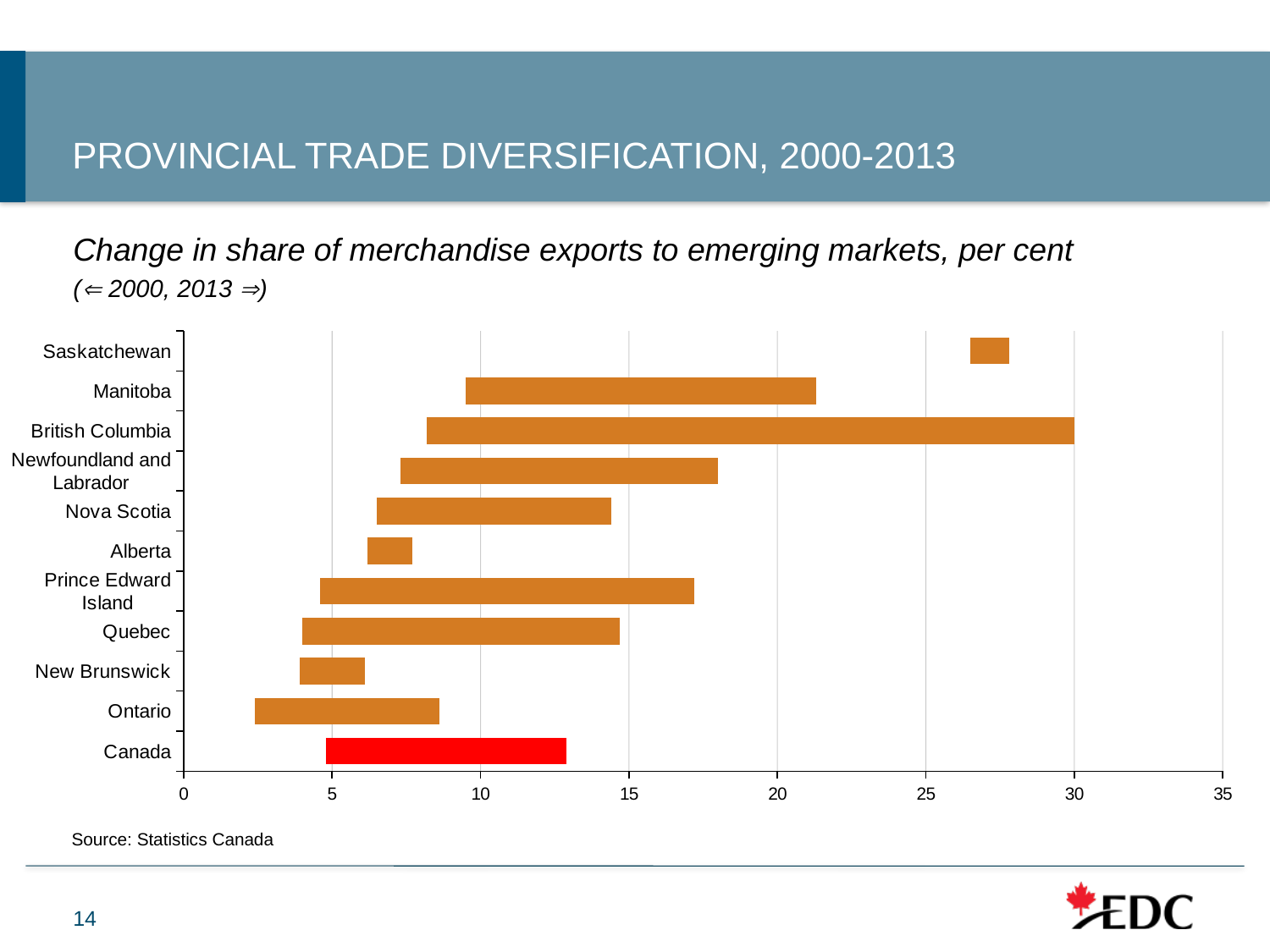
Which category has the highest 2013 share (right end of its bar) on the chart? British Columbia What is the source cited below the chart? Statistics Canada Is the 2013 share (right end of the bar) for British Columbia greater or less than 25? greater Which province has the lowest 2013 share (right end of its bar) on the chart? New Brunswick Is the 2013 share (right end of the bar) for Ontario greater or less than 10? less How many provinces/regions (categories) are listed on the chart? 11 What colour is the bar for Canada on the chart? red What kind of chart is shown on the slide? bar chart Is the 2000 share (left end of the bar) for Saskatchewan greater or less than 25? greater Which has the larger 2013 share (right end of bar): Manitoba or Newfoundland and Labrador? Manitoba